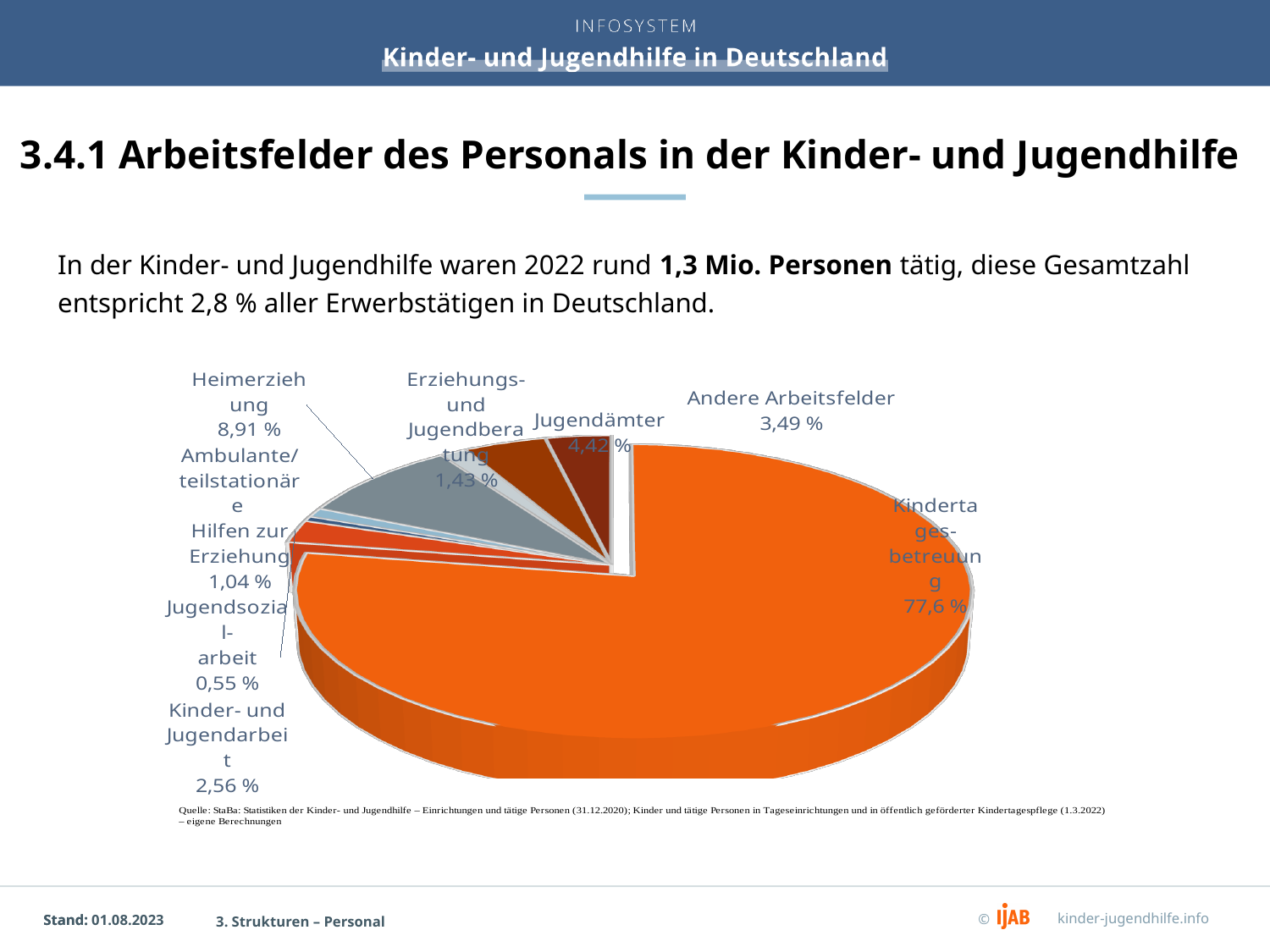
What is the value shown for Kinder- und Jugendarbeit? 2,56 % What is the value shown for Andere Arbeitsfelder? 3,49 % What kind of chart is shown on the slide? pie chart What is the value shown for Heimerziehung? 8,91 % Which category has the largest share of the pie? Kindertagesbetreuung How many categories are shown in the pie chart? 8 Which is larger, the share for Jugendämter or the share for Andere Arbeitsfelder? Jugendämter What is the value shown for Jugendämter? 4,42 % Which category has the smallest share of the pie? Jugendsozialarbeit What is the value shown for Jugendsozialarbeit? 0,55 % What is the difference between the shares for Heimerziehung and Jugendämter? 4,49 % What share of the pie does Kindertagesbetreuung have? 77,6 %